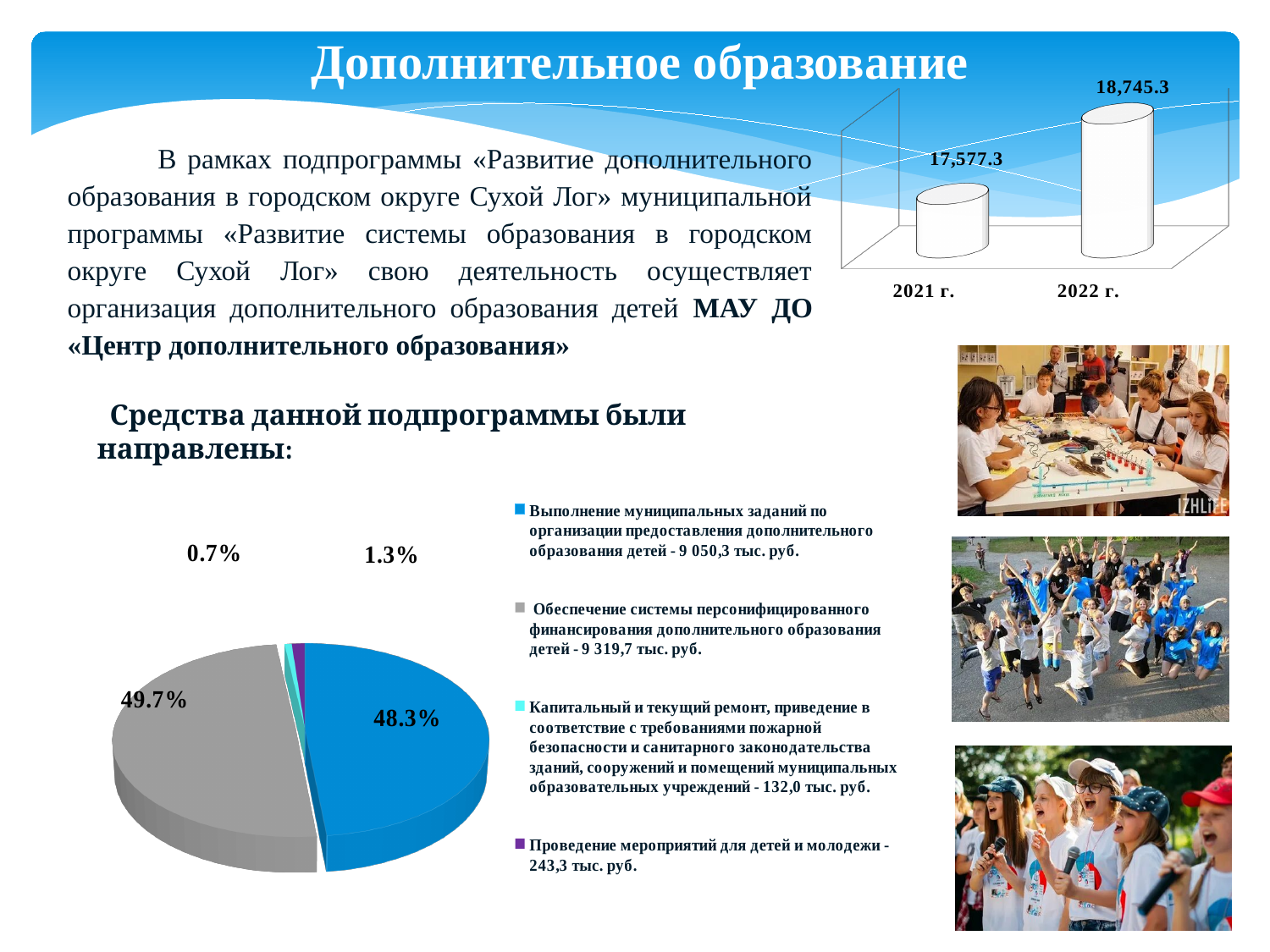
In the bar chart at the top right, how many categories are shown? 2 In the bar chart at the top right, do the values rise or fall from 2021 г. to 2022 г.? rise In the pie chart, what share is labelled for the slice 'Обеспечение системы персонифицированного финансирования дополнительного образования детей'? 49.7% In the bar chart at the top right, what is the value for 2021 г.? 17,577.3 In the pie chart, what is the difference between the 49.7% slice and the 48.3% slice? 1.4% In the pie chart, which slice is the smallest? Капитальный и текущий ремонт (0.7%) In the bar chart at the top right, which year has the higher value? 2022 г. In the bar chart at the top right, what is the value for 2022 г.? 18,745.3 What kind of chart is shown at the bottom left of the slide? pie chart In the bar chart at the top right, by how much does the 2022 г. value exceed the 2021 г. value? 1,168.0 In the pie chart, how many entries does the legend list? 4 In the pie chart, what share is labelled for the slice 'Выполнение муниципальных заданий по организации предоставления дополнительного образования детей'? 48.3%